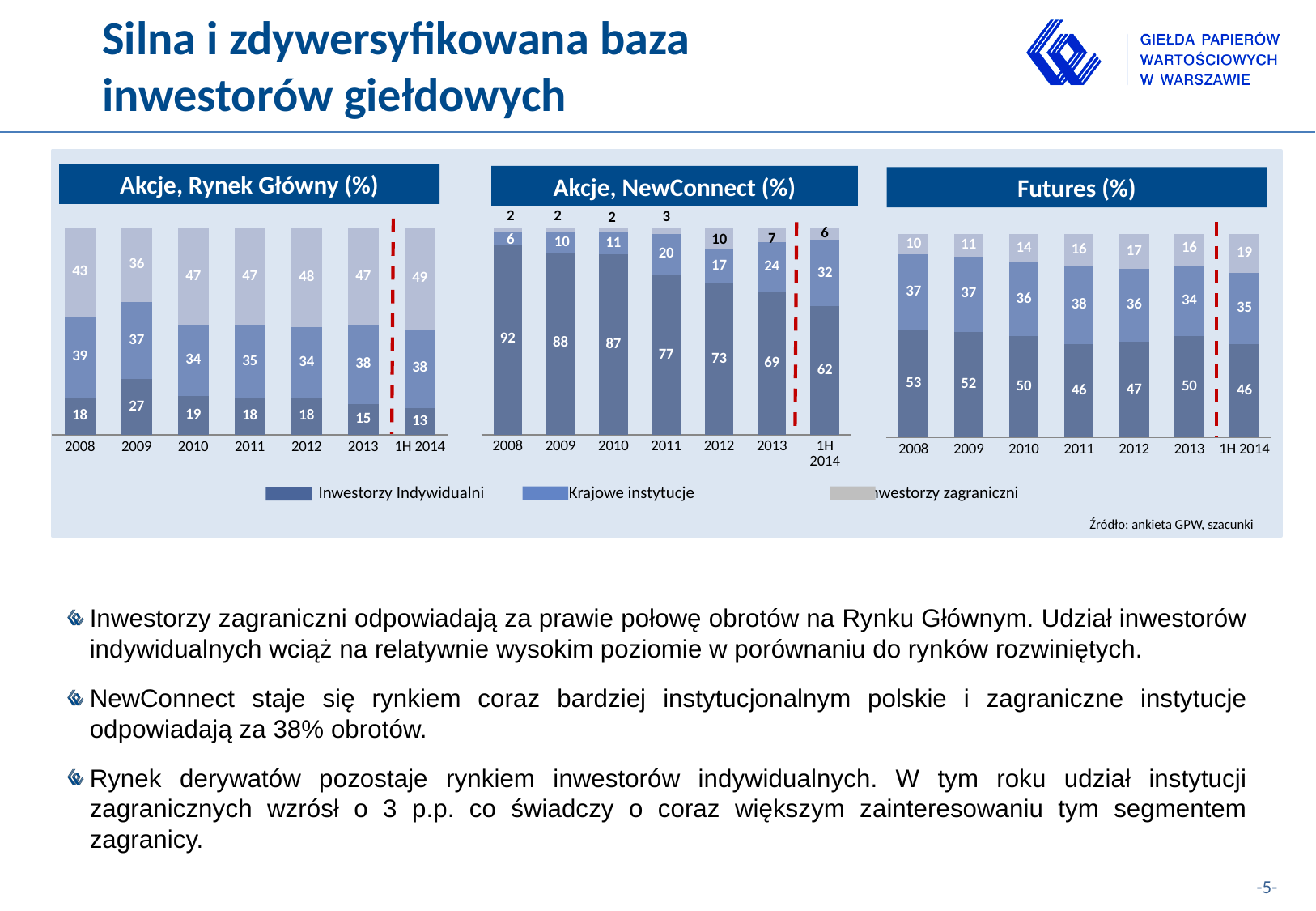
How many series does the legend list? 3 In the 'Futures (%)' chart, what is the difference between the Inwestorzy Indywidualni values for 2008 and 1H 2014? 7 In the 'Akcje, NewConnect (%)' chart, what is the value for Inwestorzy Indywidualni in 2008? 92 In the 'Akcje, NewConnect (%)' chart, is the Krajowe instytucje value larger in 2013 or in 1H 2014? 1H 2014 What kind of chart is 'Akcje, Rynek Główny (%)'? Stacked bar chart In the 'Akcje, NewConnect (%)' chart, does the Inwestorzy Indywidualni value rise or fall from 2008 to 1H 2014? Fall How many years (categories) are shown on the x axis of the 'Futures (%)' chart? 7 In the 'Akcje, Rynek Główny (%)' chart, which year has the highest value for Inwestorzy Indywidualni? 2009 In the 'Akcje, Rynek Główny (%)' chart, what is the value for Inwestorzy zagraniczni in 1H 2014? 49 In the 'Akcje, NewConnect (%)' chart, which year has the lowest value for Inwestorzy Indywidualni? 1H 2014 In the 'Futures (%)' chart, what is the value for Krajowe instytucje in 2011? 38 In the 'Akcje, Rynek Główny (%)' chart, what is the total of the stacked bar for 2009? 100